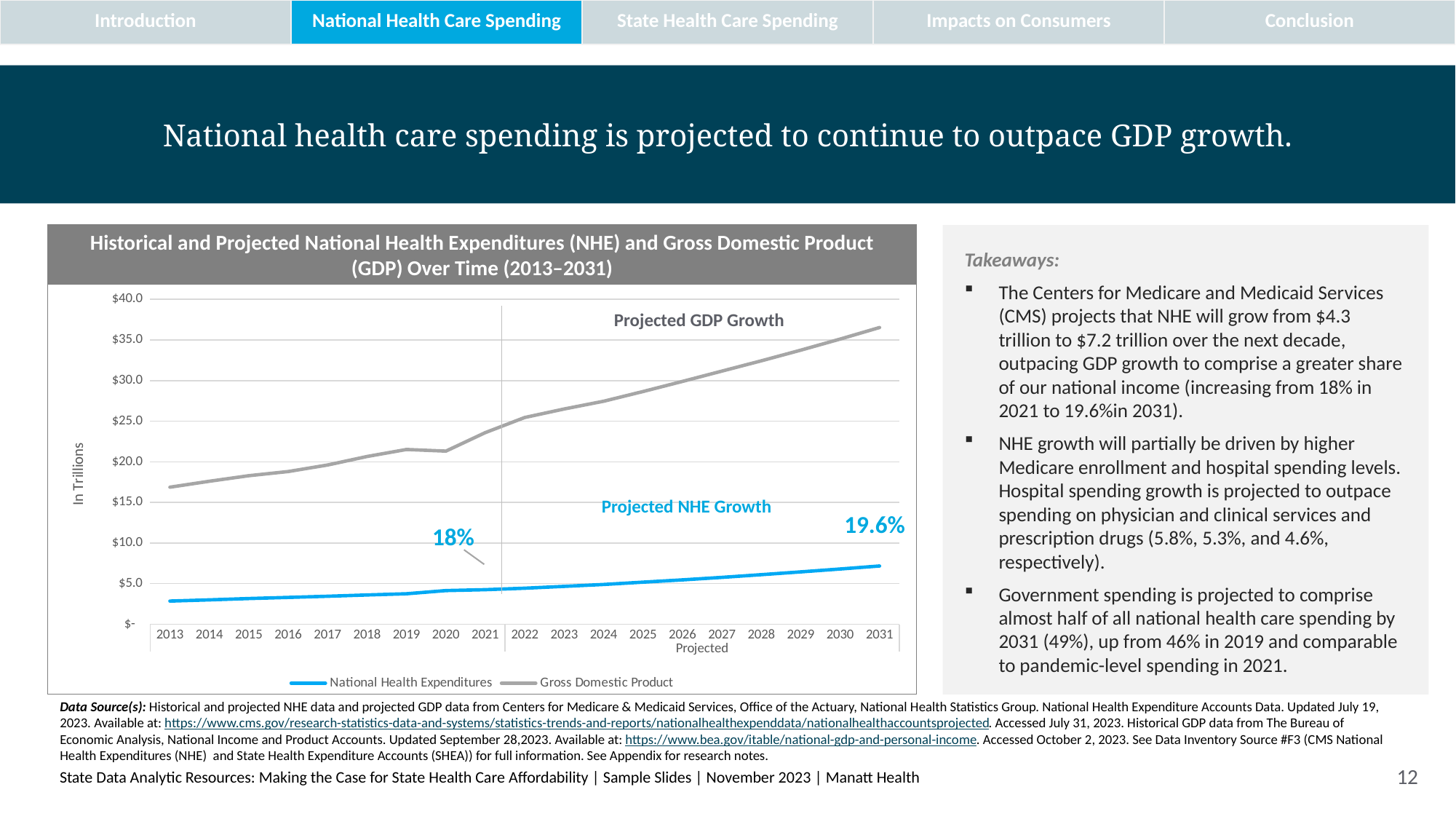
Is the Gross Domestic Product value for 2031 greater or less than $35.0 trillion? greater Is the National Health Expenditures value for 2031 greater or less than $5.0 trillion? greater Which series is higher in 2031, National Health Expenditures or Gross Domestic Product? Gross Domestic Product In which year is National Health Expenditures lowest? 2013 Is the Gross Domestic Product value for 2013 greater or less than $20.0 trillion? less How many years are shown on the x axis of the chart? 19 What is the y-axis label of the chart? In Trillions How many series does the chart legend list? 2 Does the Gross Domestic Product line rise or fall from 2013 to 2031 overall? Rise What percentage is annotated on the chart near the 2021 National Health Expenditures point? 18% In which year is Gross Domestic Product highest? 2031 What kind of chart is shown on the slide? Line chart